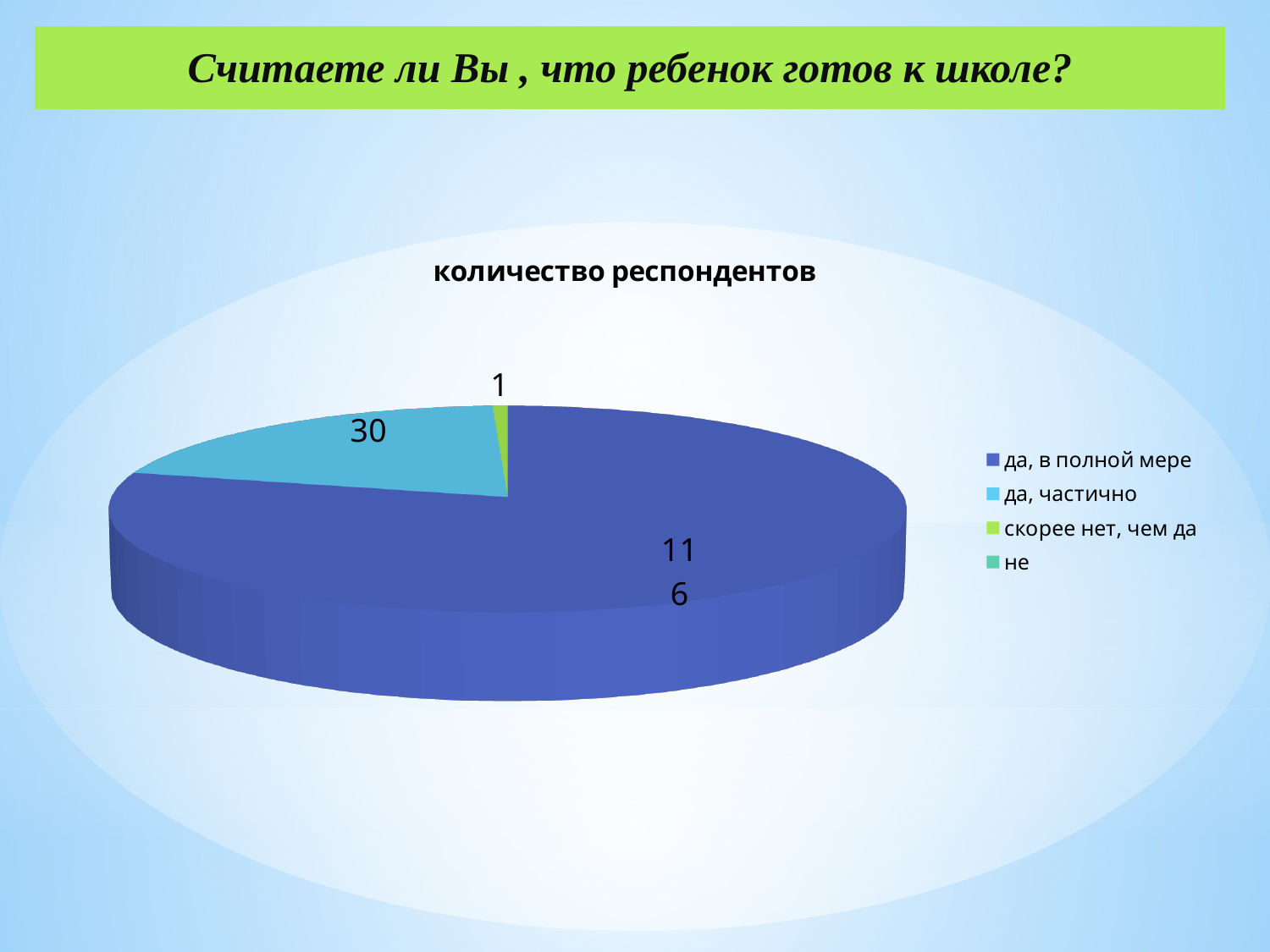
Which is larger, the value for "да, частично" or the value for "скорее нет, чем да"? да, частично What colour is the slice for "да, в полной мере"? dark blue What is the value for the slice "да, частично"? 30 What kind of chart is shown on the slide? pie chart How many entries does the chart legend list? 4 What is the value for the slice "скорее нет, чем да"? 1 What is the title of the chart? количество респондентов What is the difference between the values for "да, частично" and "скорее нет, чем да"? 29 Which category has the largest slice of the pie? да, в полной мере